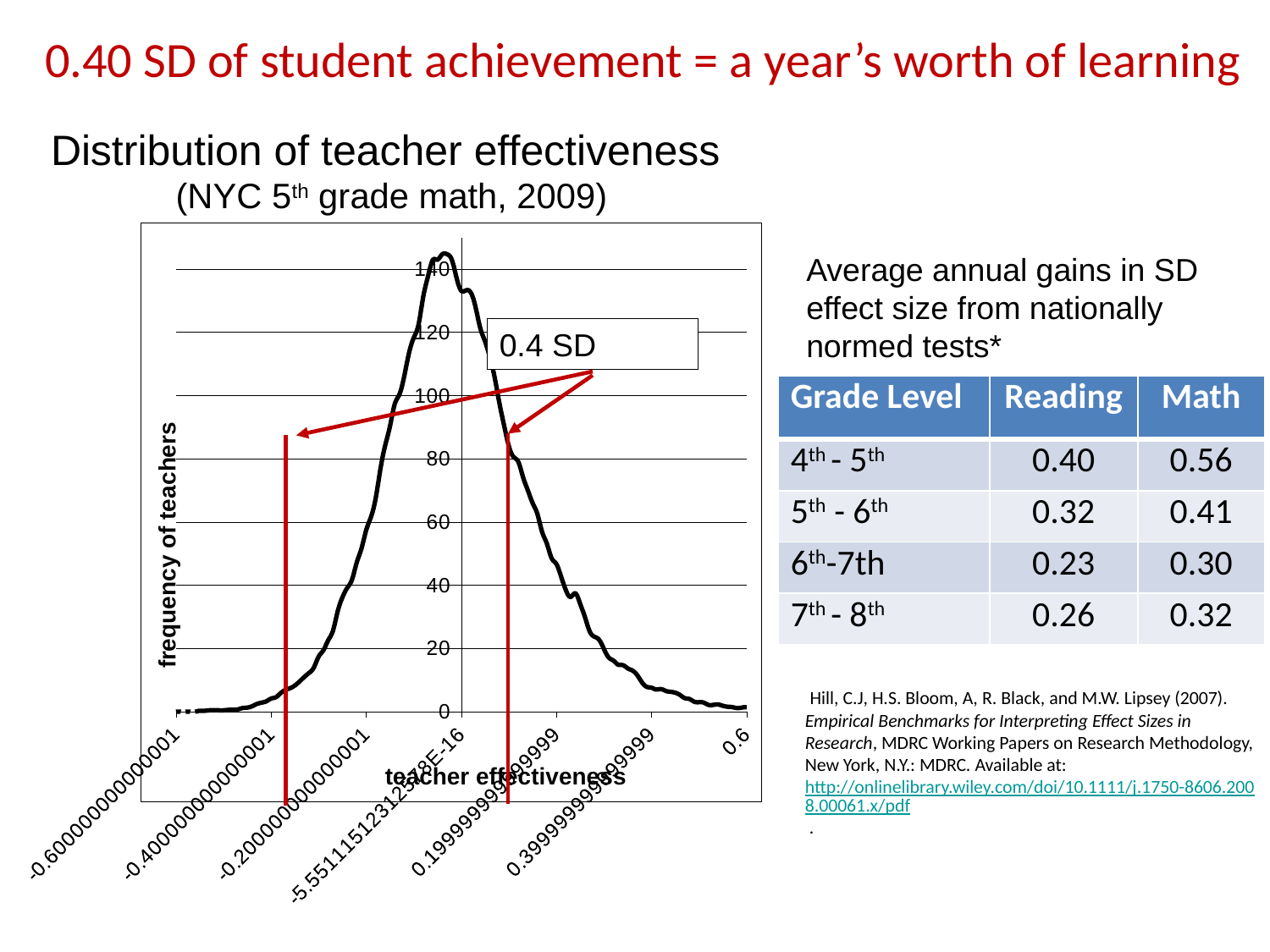
Is the frequency of teachers at a teacher effectiveness of 0.6 greater or less than 20? less Is the frequency of teachers at a teacher effectiveness of 0.4 greater or less than 40? less What is the label on the vertical axis of the distribution chart? frequency of teachers What kind of chart is used to show the distribution of teacher effectiveness? line chart What is the highest tick value shown on the vertical axis of the distribution chart? 140 What is the label on the horizontal axis of the distribution chart? teacher effectiveness Is the frequency of teachers at a teacher effectiveness of -0.6 greater or less than 20? less Does the frequency of teachers rise or fall as teacher effectiveness increases from 0.2 to 0.6? fall Does the frequency of teachers rise or fall as teacher effectiveness increases from -0.6 toward 0? rise